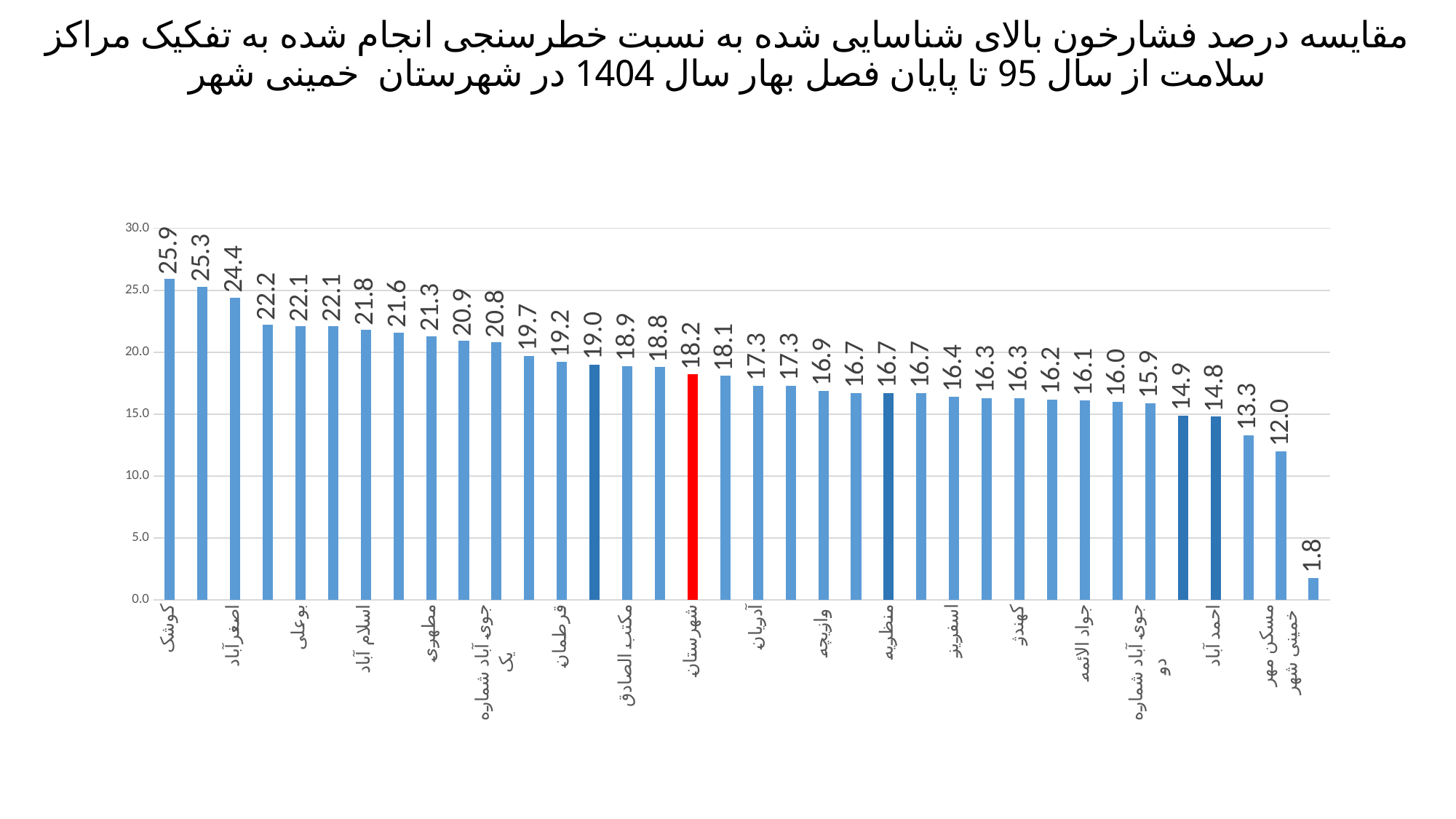
Is the value for اسلام آباد greater or less than 20.0? greater What kind of chart is shown on the slide? bar chart What is the value for شهرستان (the red bar)? 18.2 What is the lowest value shown on the chart? 1.8 What is the value for احمد آباد? 14.8 What is the value for کوشک? 25.9 What is the value for منظریه? 16.7 Which category is highlighted with a red bar? شهرستان What is the value for مسکن مهر خمینی شهر? 12.0 Which labeled category has the highest value? کوشک Which has a larger value, آدریان or وازیچه? آدریان What is the difference between the values for کوشک and شهرستان? 7.7